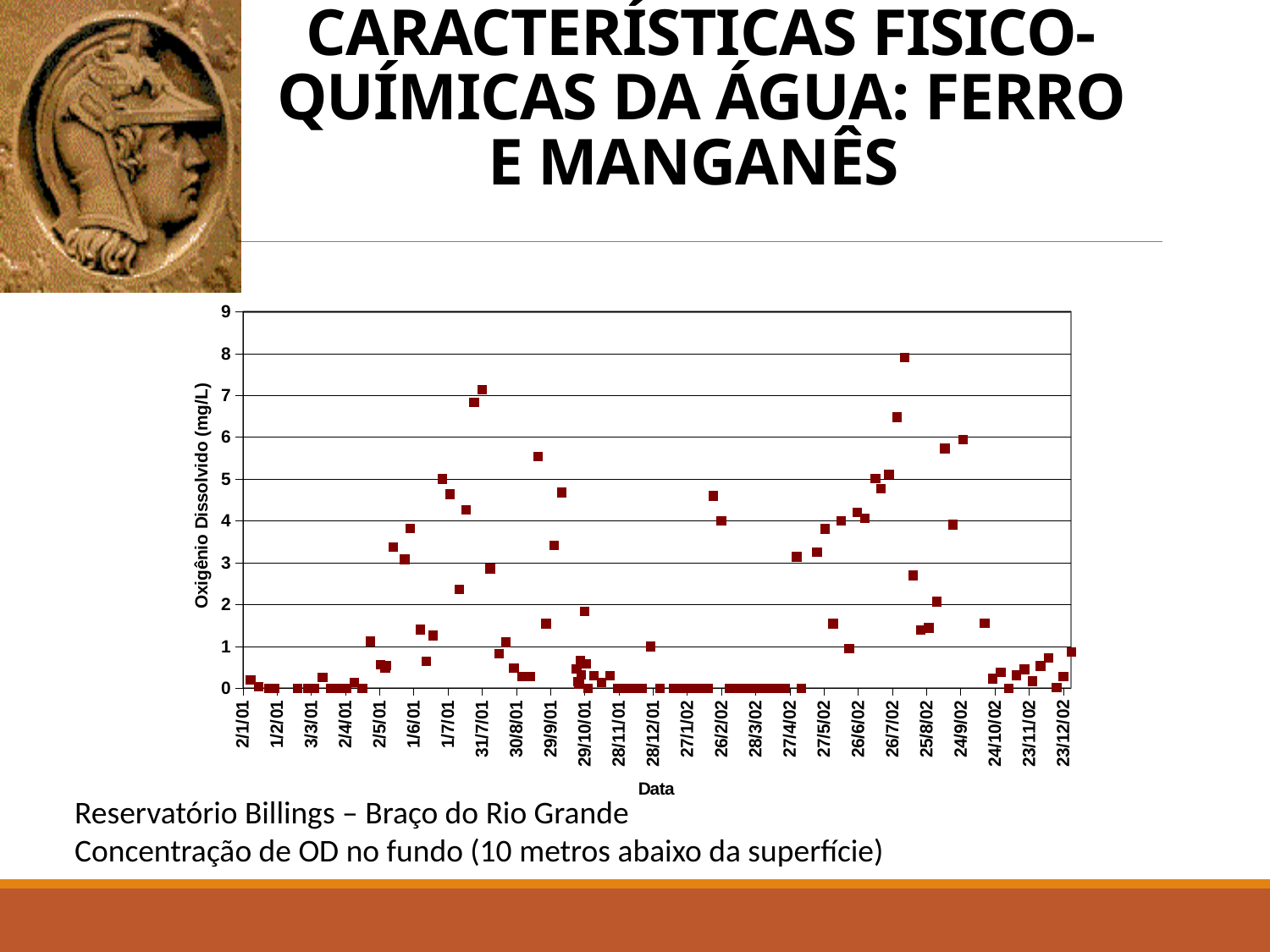
Are the values plotted around 2/1/01 greater or less than 1? less Do the plotted values generally rise or fall between 27/4/02 and 26/7/02? rise Is the highest plotted value on the chart greater or less than 7? greater What kind of chart is shown on the slide? scatter chart Do the plotted values generally rise or fall between 2/5/01 and 1/7/01? rise What is the label of the vertical axis of the chart? Oxigênio Dissolvido (mg/L) What is the label of the horizontal axis of the chart? Data Is the highest point plotted near 31/7/01 greater or less than 6? greater